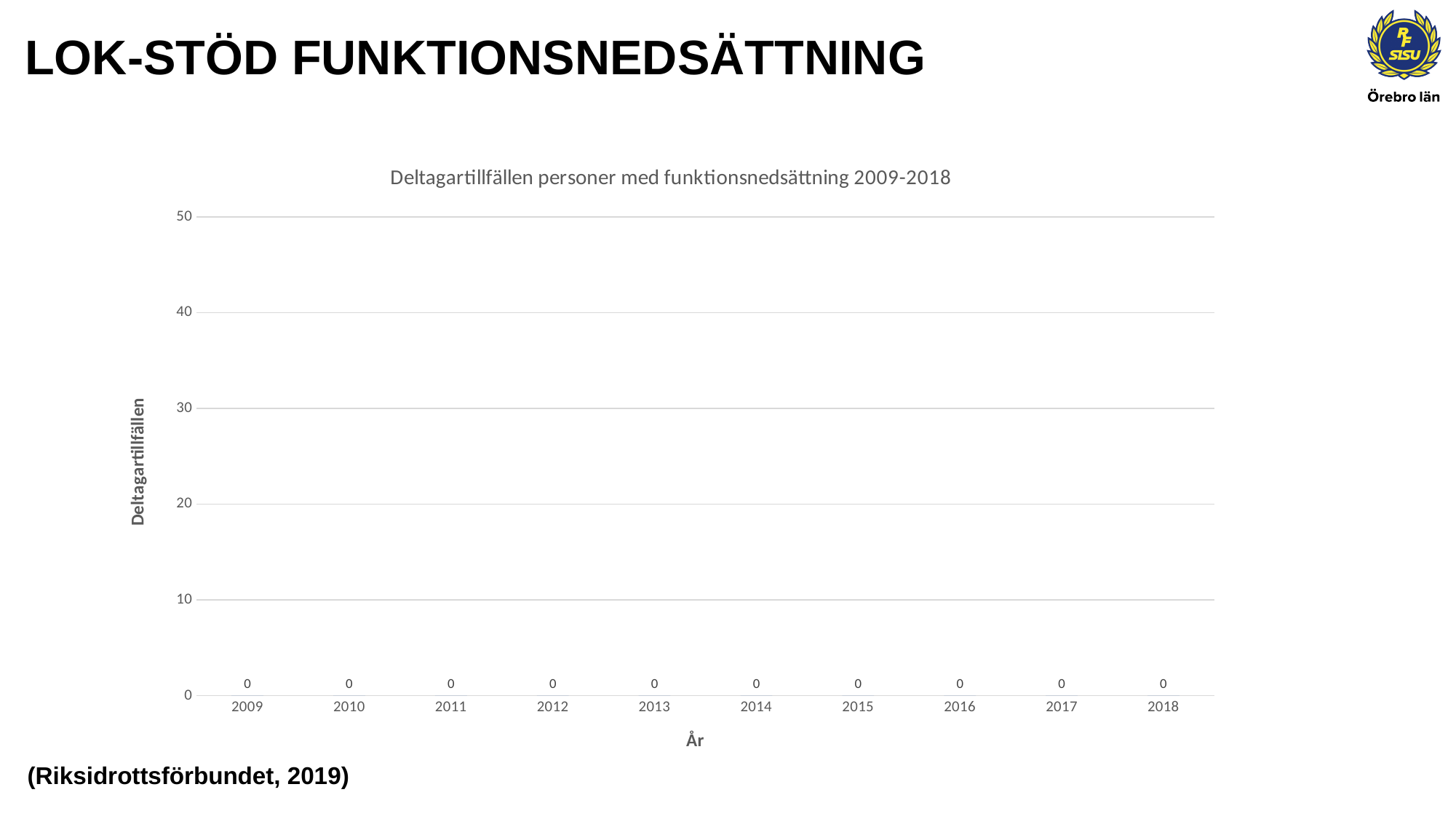
What is the value for 2009 in the chart? 0 What is the title of the chart? Deltagartillfällen personer med funktionsnedsättning 2009-2018 What is the value for 2018 in the chart? 0 What is the label of the y axis of the chart? Deltagartillfällen What is the difference between the values for 2017 and 2010? 0 What is the value for 2014 in the chart? 0 How many years are shown on the x axis of the chart? 10 Is the value for 2015 greater or less than 10? less Do the values rise, fall, or stay the same from 2009 to 2018? stay the same What is the value for 2012 in the chart? 0 Is the value for 2011 greater or less than 20? less